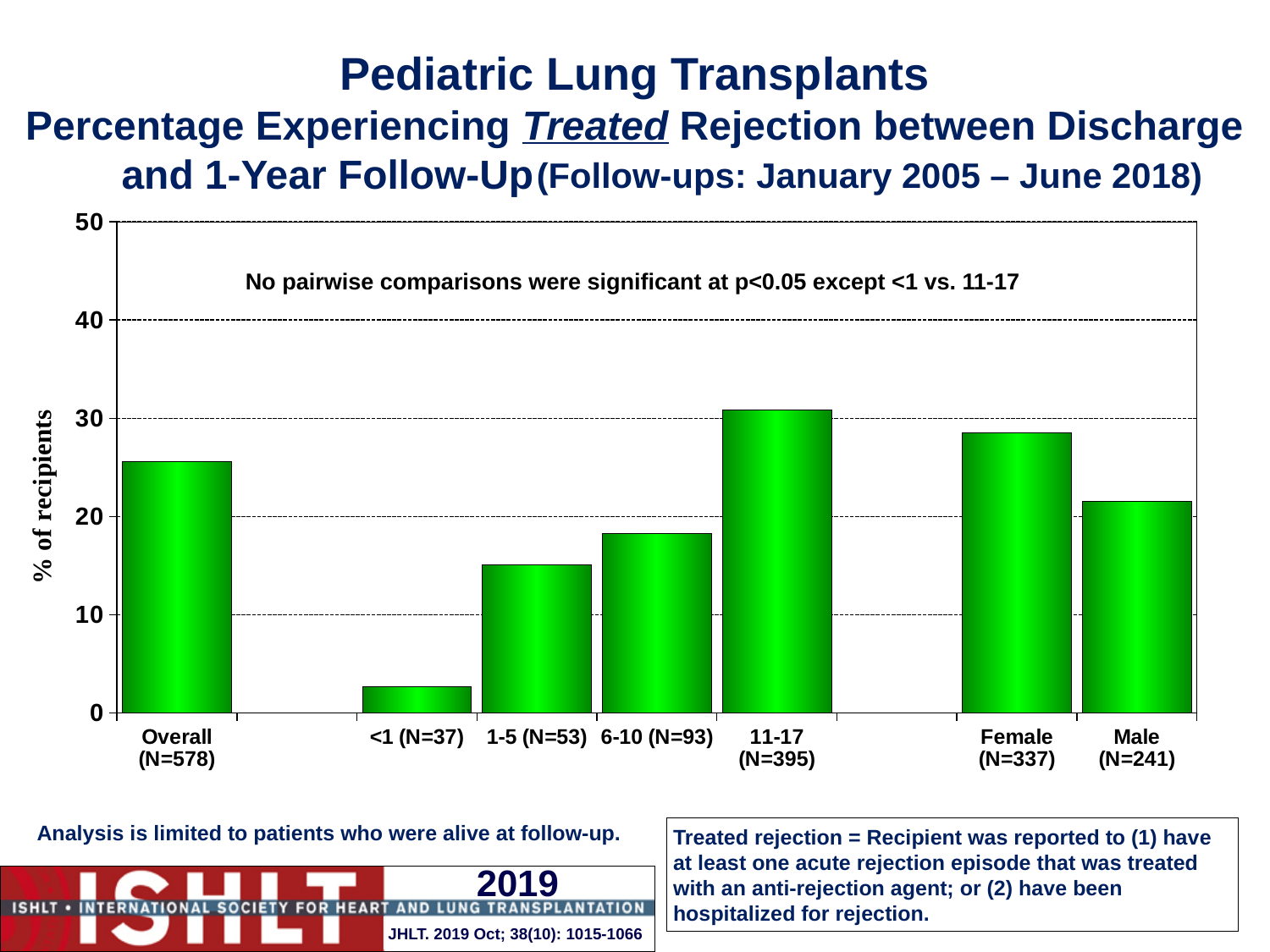
What is the label on the y axis of the chart? % of recipients Is the value for 11-17 (N=395) greater or less than 30? greater How many bars (categories) are plotted in the chart? 7 Is the value for <1 (N=37) greater or less than 10? less Which is larger, the value for 1-5 (N=53) or the value for 6-10 (N=93)? 6-10 (N=93) Across the age groups from <1 to 11-17, do the values rise or fall? rise What kind of chart is shown on the slide? bar chart Which is larger, the value for Female (N=337) or the value for Male (N=241)? Female (N=337) Which category has the lowest percentage of recipients experiencing treated rejection? <1 (N=37) Is the value for Overall (N=578) greater or less than 30? less Which category has the highest percentage of recipients experiencing treated rejection? 11-17 (N=395)